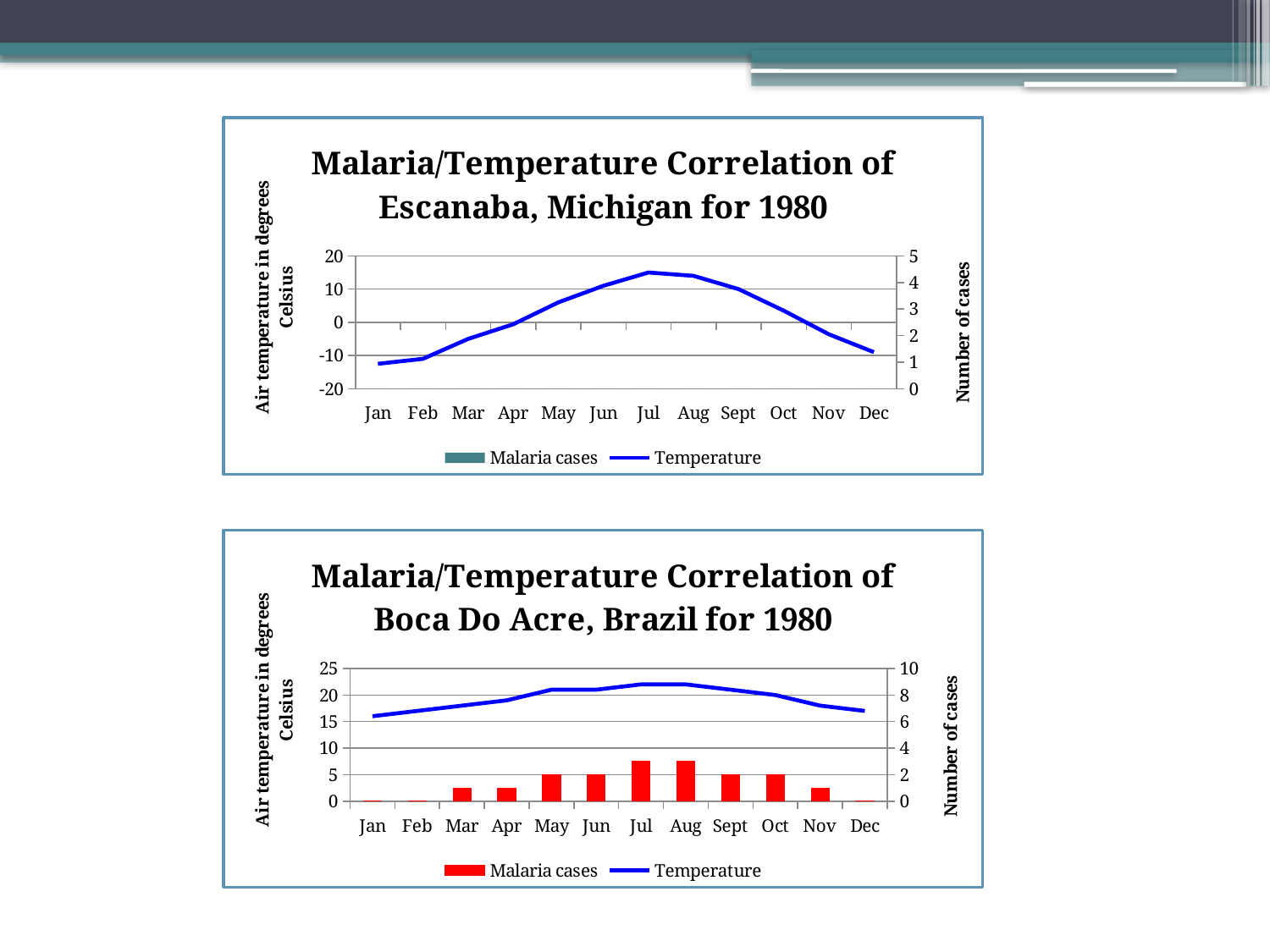
How many months are shown on the x axis of the Boca Do Acre, Brazil chart? 12 How many series does the legend of the Escanaba, Michigan chart list? 2 In the Escanaba, Michigan chart, which month has the lowest temperature? Jan In the Boca Do Acre, Brazil chart, which month has the lowest temperature? Jan What kind of chart is the Boca Do Acre, Brazil chart? Combined bar and line chart In the Escanaba, Michigan chart, is the temperature for Jan greater or less than -10? less In the Escanaba, Michigan chart, which month has the highest temperature? Jul What colour are the malaria cases bars in the Boca Do Acre, Brazil chart? Red In the Escanaba, Michigan chart, does the temperature rise or fall from Jan to Jul? Rise In the Boca Do Acre, Brazil chart, is the temperature for Jul greater or less than 20? greater In the Escanaba, Michigan chart, is the temperature for Jul greater or less than 10? greater In the Boca Do Acre, Brazil chart, which has more malaria cases, Jul or Mar? Jul